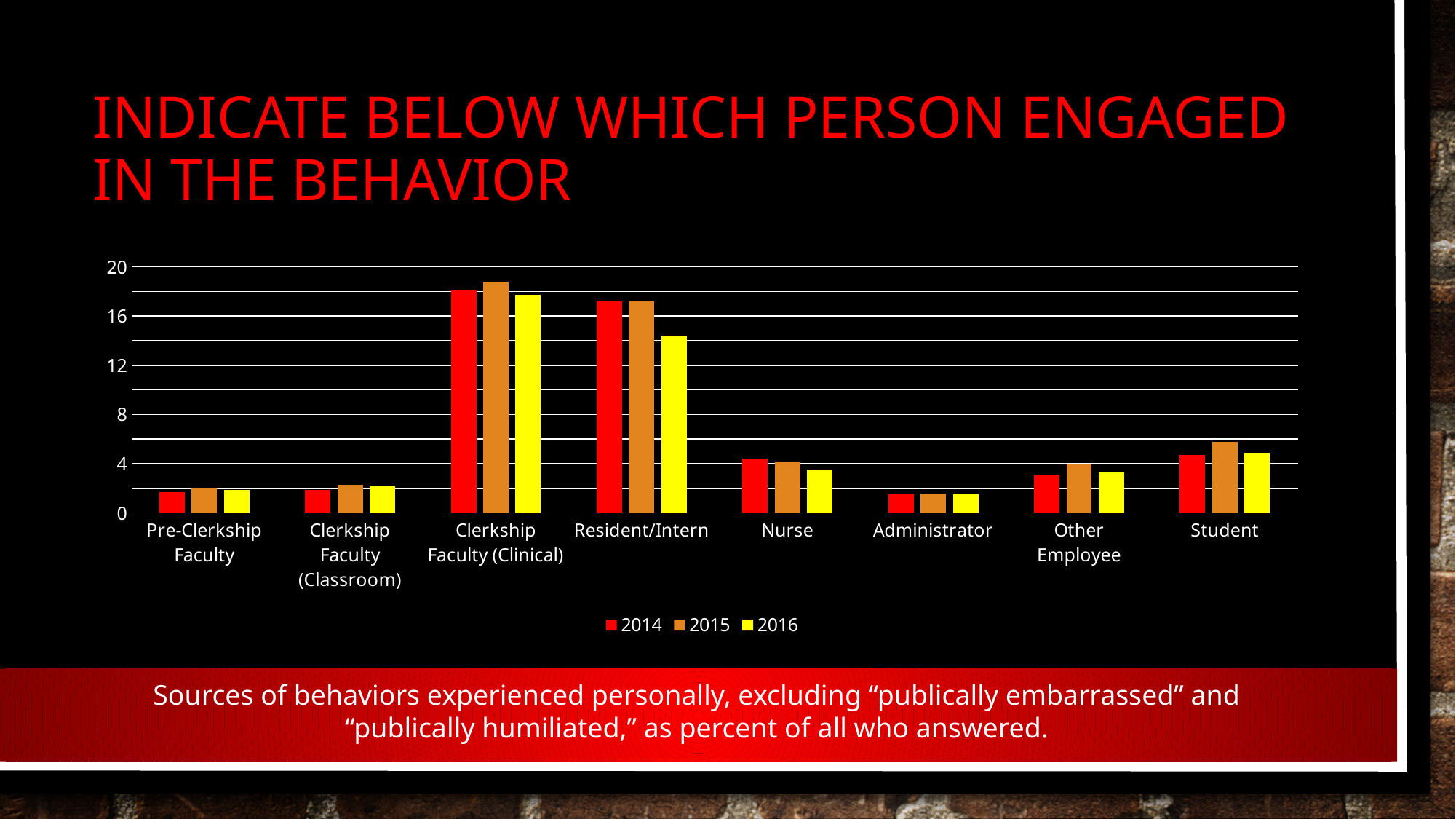
Is the 2016 value for Resident/Intern greater or less than 16? less For Resident/Intern, does the value rise or fall from 2015 to 2016? fall Is the 2015 value for Clerkship Faculty (Clinical) greater or less than 16? greater What kind of chart is shown on the slide? bar chart Is the 2015 value for Student greater or less than 4? greater Which is larger for 2016: the value for Clerkship Faculty (Clinical) or the value for Resident/Intern? Clerkship Faculty (Clinical) How many categories are shown on the x axis of the chart? 8 Which category has the highest value for 2015? Clerkship Faculty (Clinical) Which is larger for 2015: the value for Student or the value for Nurse? Student Which colour represents the 2016 series in the chart? yellow How many series does the chart's legend list? 3